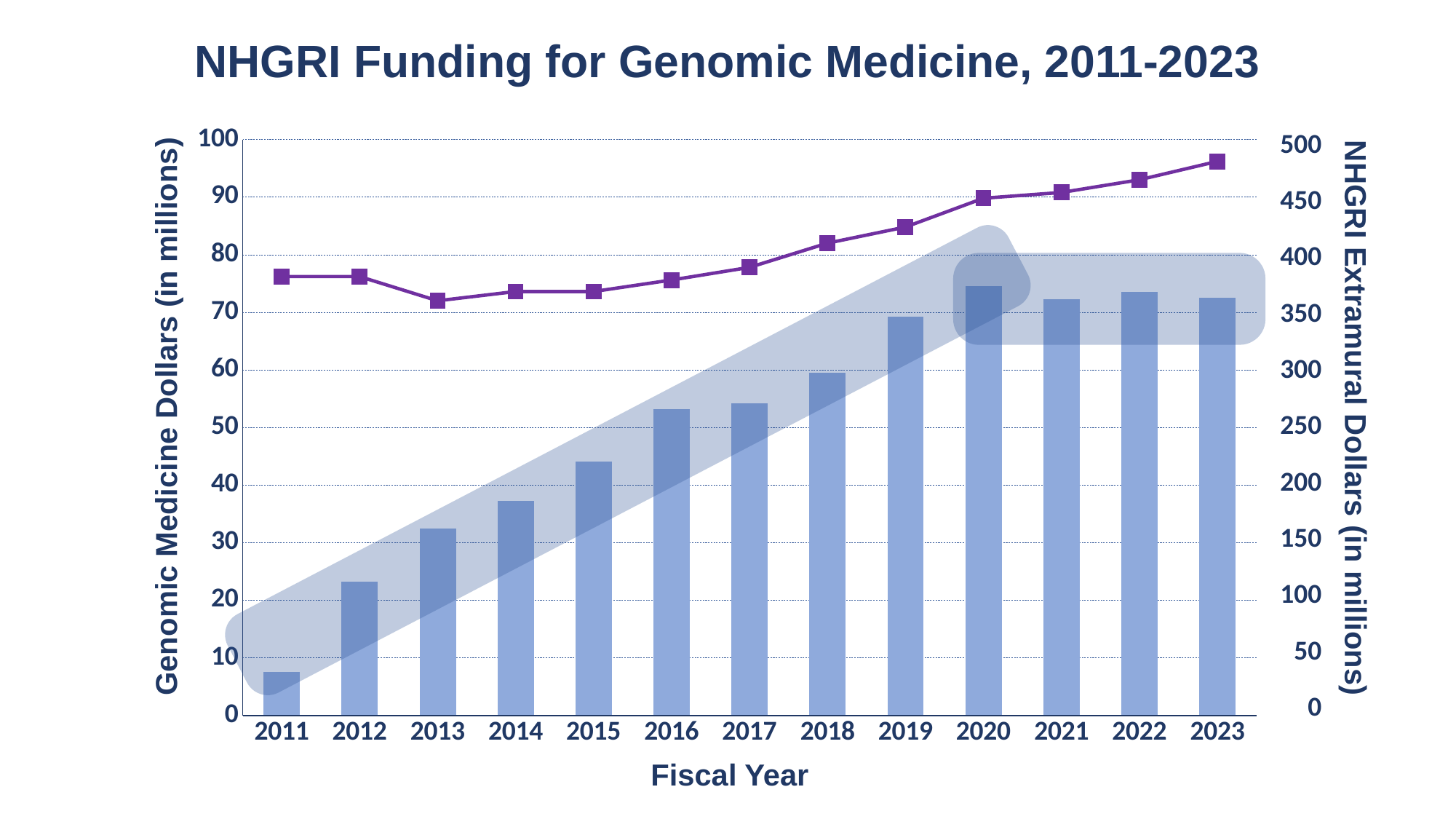
Is the Genomic Medicine Dollars bar for 2020 greater or less than 70? greater Do the Genomic Medicine Dollars bars generally rise or fall from 2011 to 2020? rise Which is larger, the Genomic Medicine Dollars bar for 2015 or for 2019? 2019 Which fiscal year has the lowest bar for Genomic Medicine Dollars? 2011 How many fiscal years are shown on the x axis? 13 In which fiscal year does the NHGRI Extramural Dollars line reach its highest point? 2023 Is the NHGRI Extramural Dollars value for 2023 greater or less than 450? greater What kind of chart is shown on the slide? A combined bar and line chart Is the Genomic Medicine Dollars bar for 2011 greater or less than 10? less What is the title of the chart? NHGRI Funding for Genomic Medicine, 2011-2023 In which fiscal year does the NHGRI Extramural Dollars line reach its lowest point? 2013